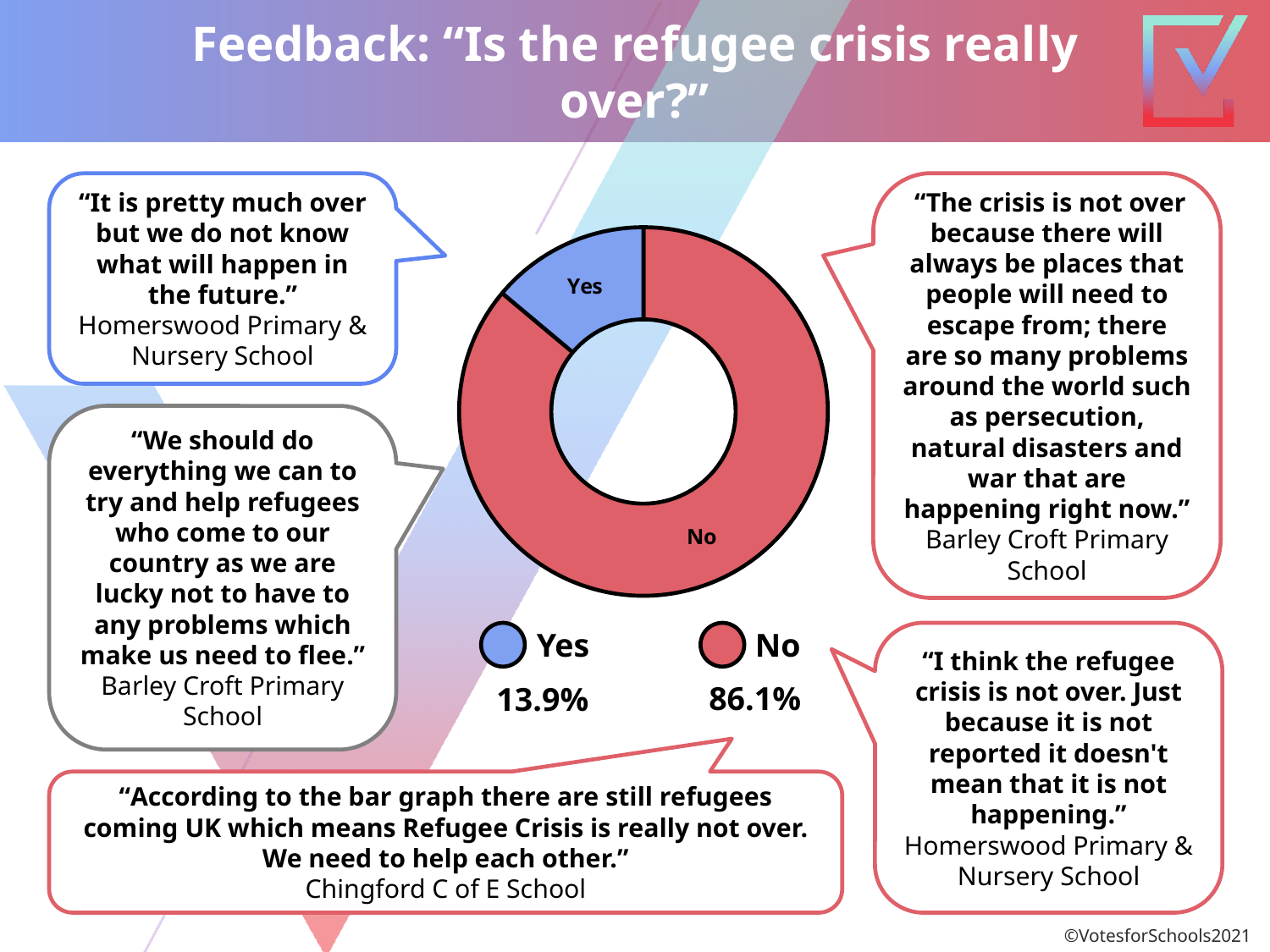
What colour represents the "No" response in the chart? Red Which is larger, the share for "Yes" or the share for "No"? No Which response received the largest share of the vote? No What is the total of the two percentages shown in the chart? 100% What percentage of respondents answered "No"? 86.1% What colour represents the "Yes" response in the chart? Blue Is the share for "No" greater or less than 50%? greater What is the difference in percentage points between the "No" and "Yes" responses? 72.2 Which response received the smallest share of the vote? Yes What kind of chart is shown on the slide? Doughnut (pie) chart How many categories are shown in the chart? 2 What percentage of respondents answered "Yes"? 13.9%